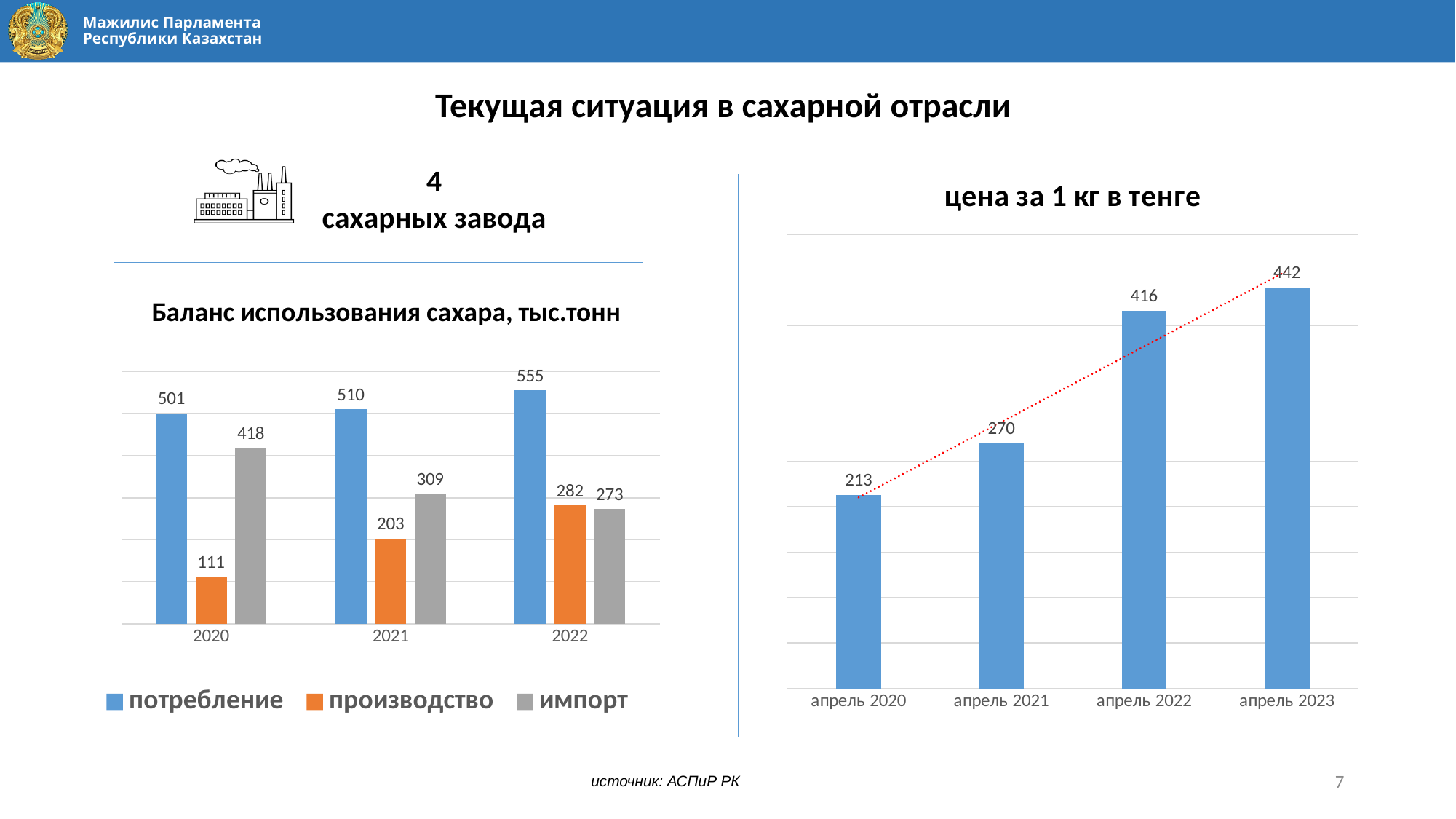
In the chart 'цена за 1 кг в тенге', what is the value for апрель 2022? 416 In the chart 'цена за 1 кг в тенге', do the values rise or fall from апрель 2020 to апрель 2023? rise In the chart 'Баланс использования сахара, тыс.тонн', which year has the highest импорт value? 2020 In the chart 'Баланс использования сахара, тыс.тонн', what is the difference between потребление and производство in 2021? 307 How many categories are shown on the x axis of the chart 'цена за 1 кг в тенге'? 4 In the chart 'цена за 1 кг в тенге', which period has the lowest value? апрель 2020 In the chart 'Баланс использования сахара, тыс.тонн', what is the value for импорт in 2021? 309 In the chart 'Баланс использования сахара, тыс.тонн', what is the value for производство in 2020? 111 In the chart 'цена за 1 кг в тенге', what is the difference between апрель 2023 and апрель 2020? 229 In the chart 'Баланс использования сахара, тыс.тонн', what is the value for потребление in 2022? 555 In the chart 'Баланс использования сахара, тыс.тонн', which is larger in 2022: производство or импорт? производство How many series does the legend of the chart 'Баланс использования сахара, тыс.тонн' list? 3